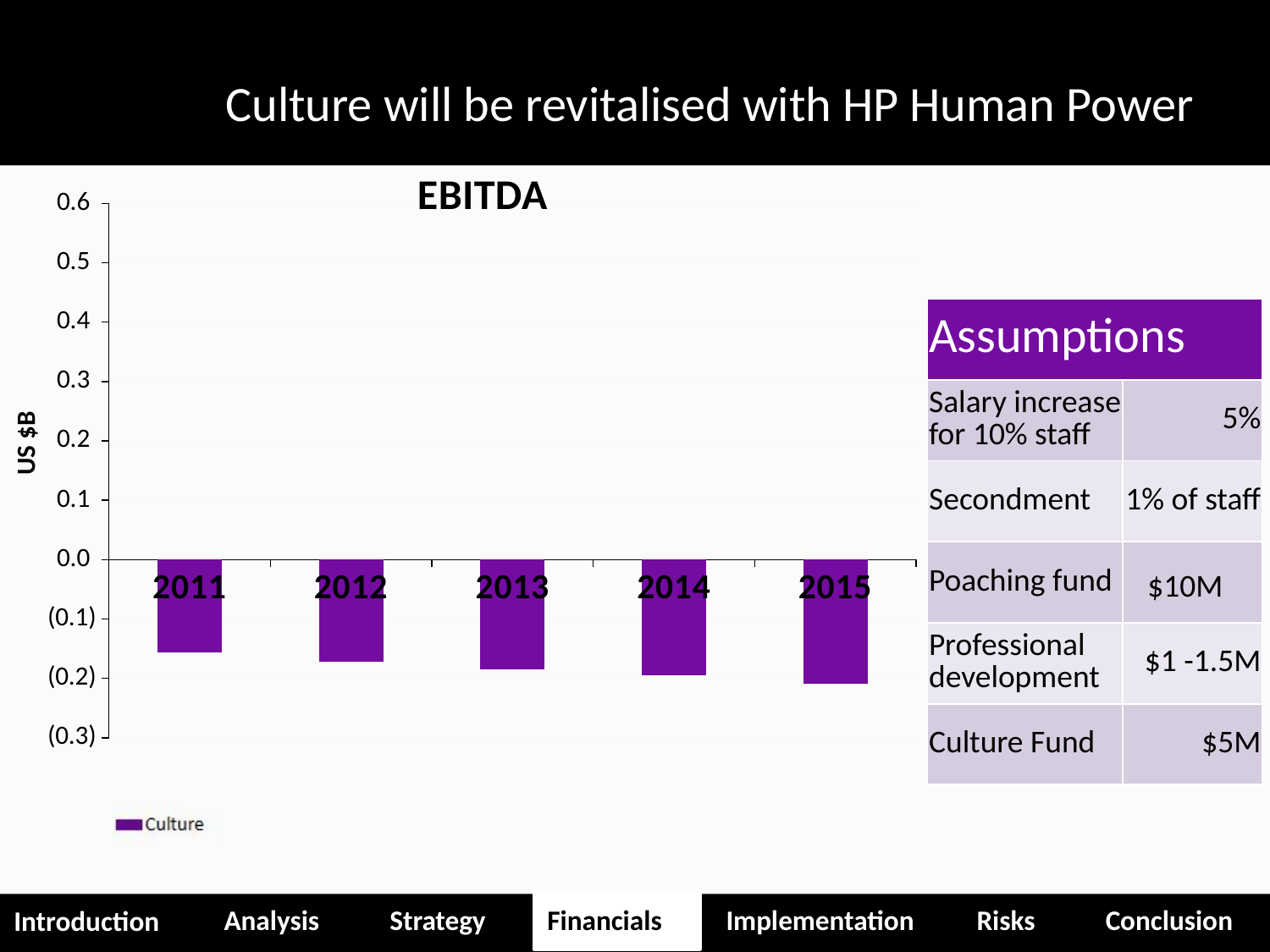
What is the label on the vertical axis of the EBITDA chart? US $B Which year has the highest (least negative) EBITDA value? 2011 Is the EBITDA value for 2011 greater or less than (0.1)? less How many series does the legend of the EBITDA chart list? 1 Which is larger, the EBITDA value for 2011 or for 2015? 2011 Do the EBITDA values rise or fall from 2011 to 2015? fall Which year has the lowest (most negative) EBITDA value? 2015 Is the EBITDA value for 2011 greater or less than (0.2)? greater What kind of chart is the EBITDA chart? bar chart What is the title of the chart? EBITDA Are the EBITDA values for all years positive or negative? negative How many years are shown on the x axis of the EBITDA chart? 5